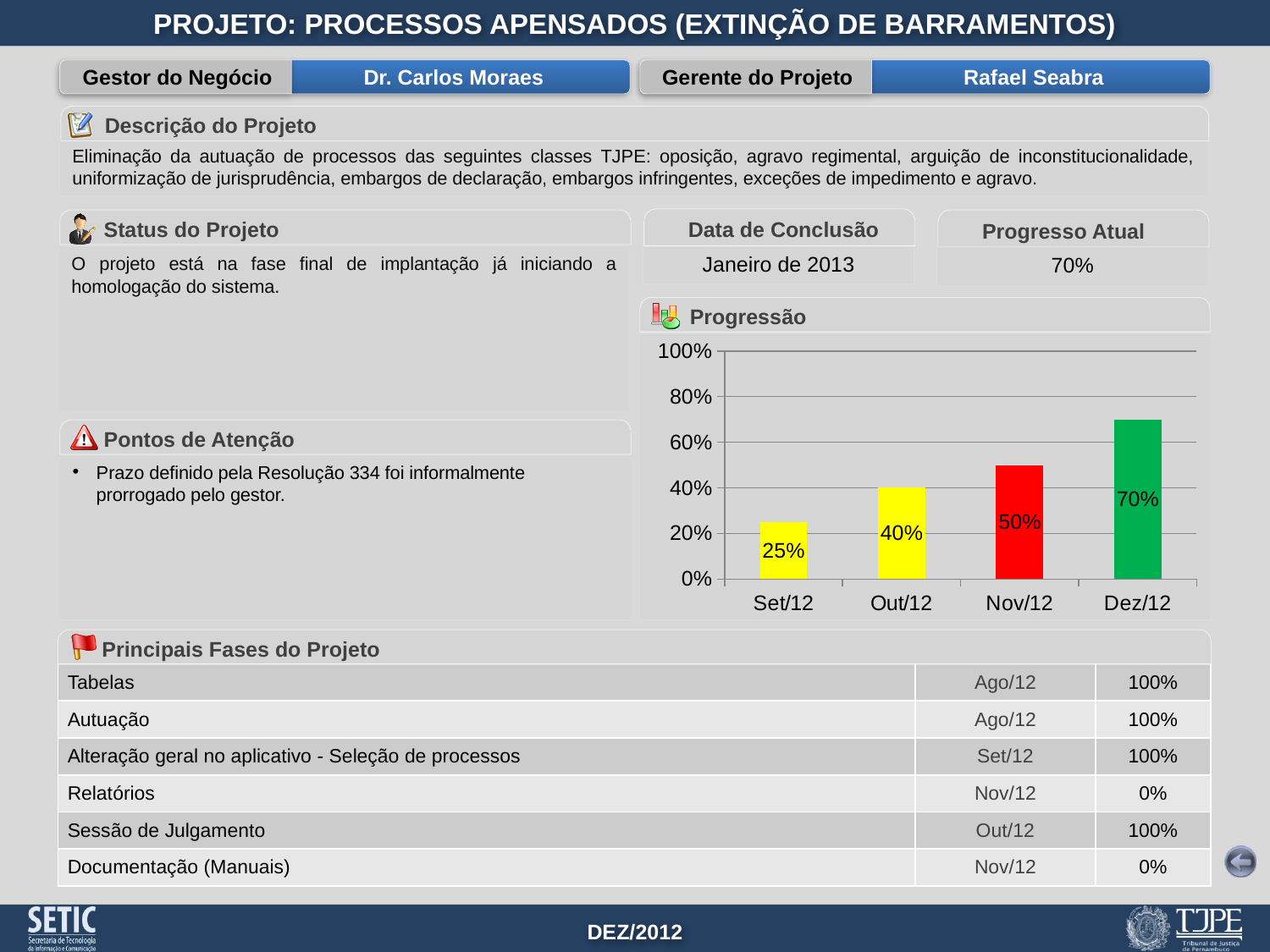
What is the value for Dez/12 in the Progressão chart? 70% What is the difference between the values for Nov/12 and Out/12 in the Progressão chart? 10% Do the values in the Progressão chart rise or fall from Set/12 to Dez/12? Rise What is the value for Set/12 in the Progressão chart? 25% What kind of chart is the Progressão chart? Bar chart What is the value for Out/12 in the Progressão chart? 40% What is the value for Nov/12 in the Progressão chart? 50% How many months are shown on the x axis of the Progressão chart? 4 Which month has the lowest value in the Progressão chart? Set/12 Which month has the highest value in the Progressão chart? Dez/12 Which is larger in the Progressão chart, the value for Out/12 or the value for Nov/12? Nov/12 What is the difference between the values for Dez/12 and Set/12 in the Progressão chart? 45%